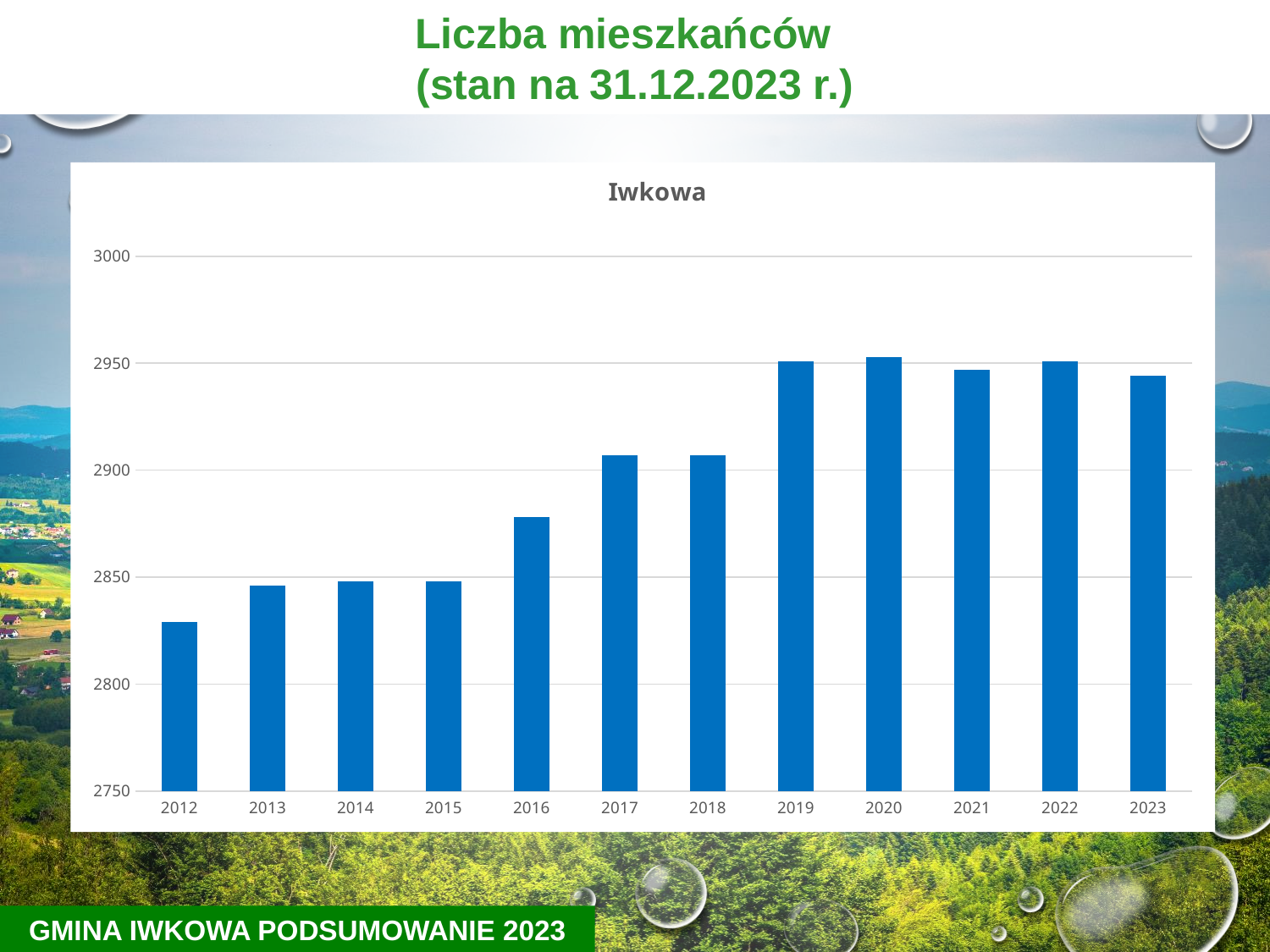
Is the value for 2017 greater or less than 2900? greater Do the values generally rise or fall from 2012 to 2023? rise Which is larger, the value for 2013 or the value for 2023? 2023 Is the value for 2012 greater or less than 2850? less How many years are shown on the x axis of the chart? 12 Which year has the lowest number of inhabitants in the chart? 2012 Is the value for 2016 greater or less than 2850? greater What is the title shown inside the chart area? Iwkowa Which is larger, the value for 2012 or the value for 2016? 2016 What kind of chart is shown on the slide? bar chart